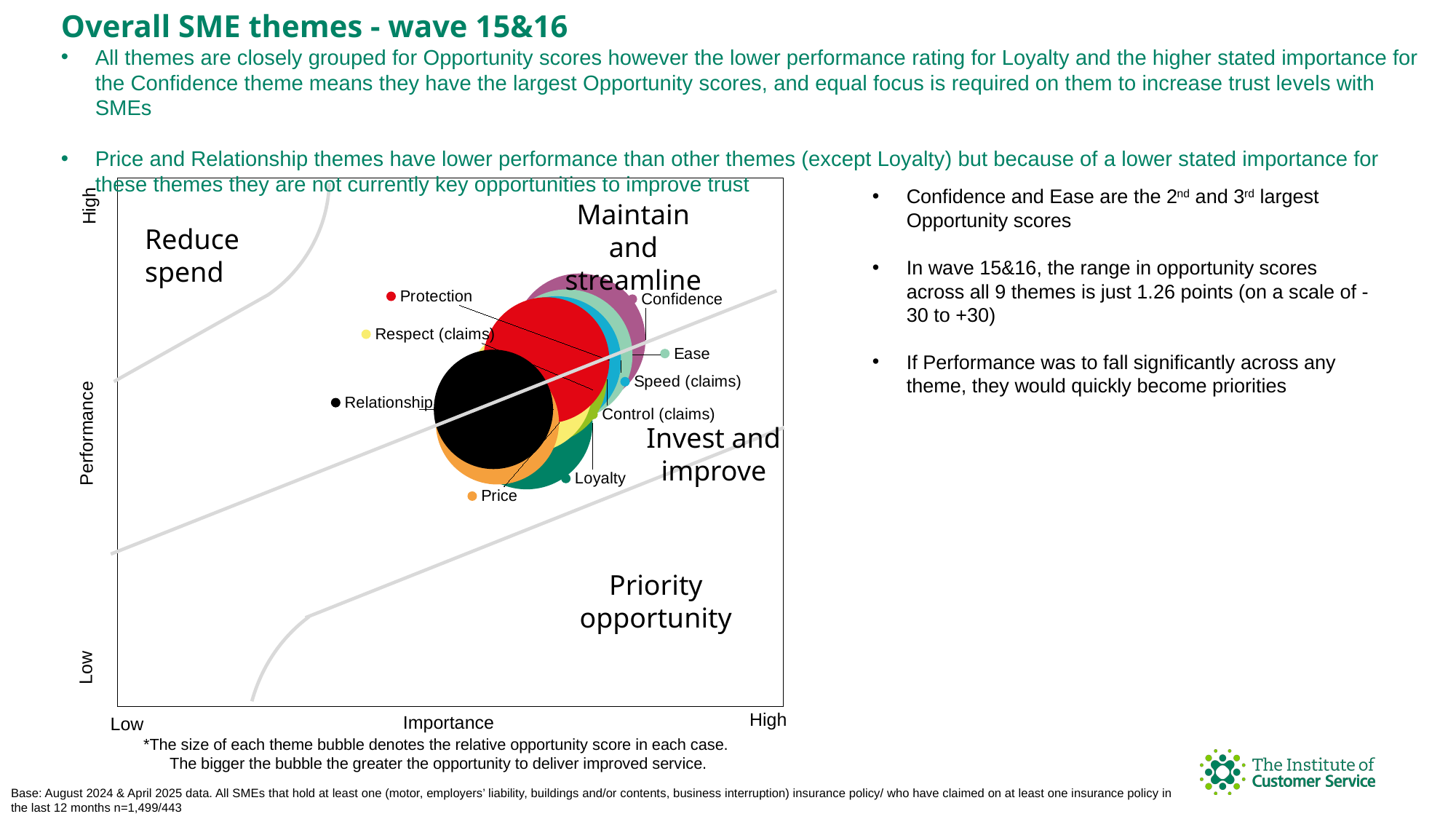
Which theme has the lowest Performance on the chart? Loyalty Which theme has higher Performance, Protection or Loyalty? Protection What kind of chart is shown on the slide? Bubble chart Which theme has higher Importance, Relationship or Speed (claims)? Speed (claims) What is the label of the vertical axis of the chart? Performance What is the label of the horizontal axis of the chart? Importance How many themes are plotted on the chart? 9 Which theme has the highest Performance on the chart? Confidence Which theme has higher Performance, Confidence or Price? Confidence